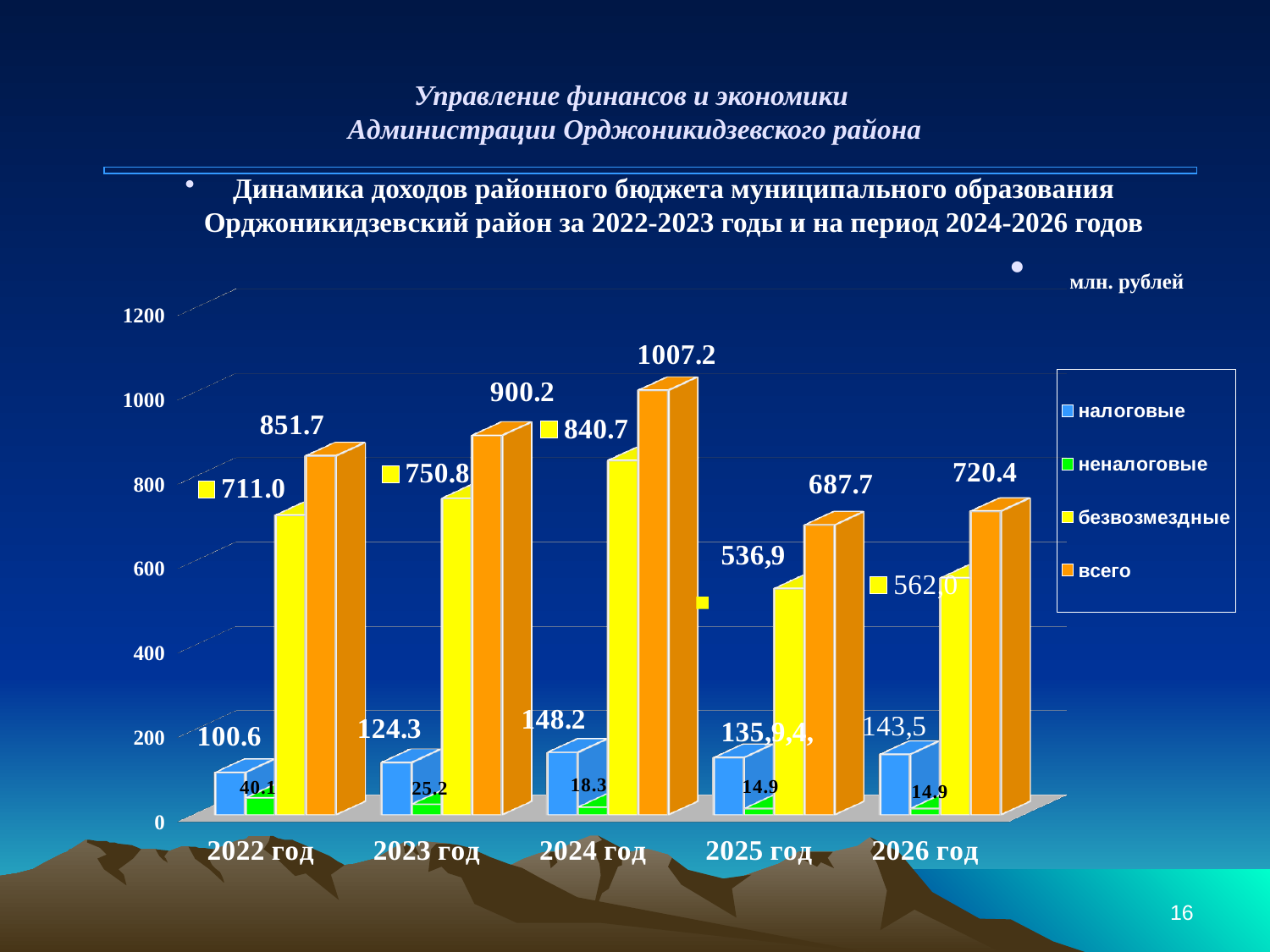
In which year is the всего value lowest? 2025 год What is the value of неналоговые for 2024 год? 18.3 How many years are shown on the x axis? 5 What type of chart is shown on the slide? bar chart What is the value of всего for 2026 год? 720.4 What is the value of безвозмездные for 2022 год? 711.0 Which is larger: безвозмездные for 2023 год or безвозмездные for 2024 год? 2024 год What is the difference between всего for 2024 год and всего for 2023 год? 107.0 What is the value of всего for 2024 год? 1007.2 How many series does the legend list? 4 In which year is the всего value highest? 2024 год What is the value of налоговые for 2023 год? 124.3